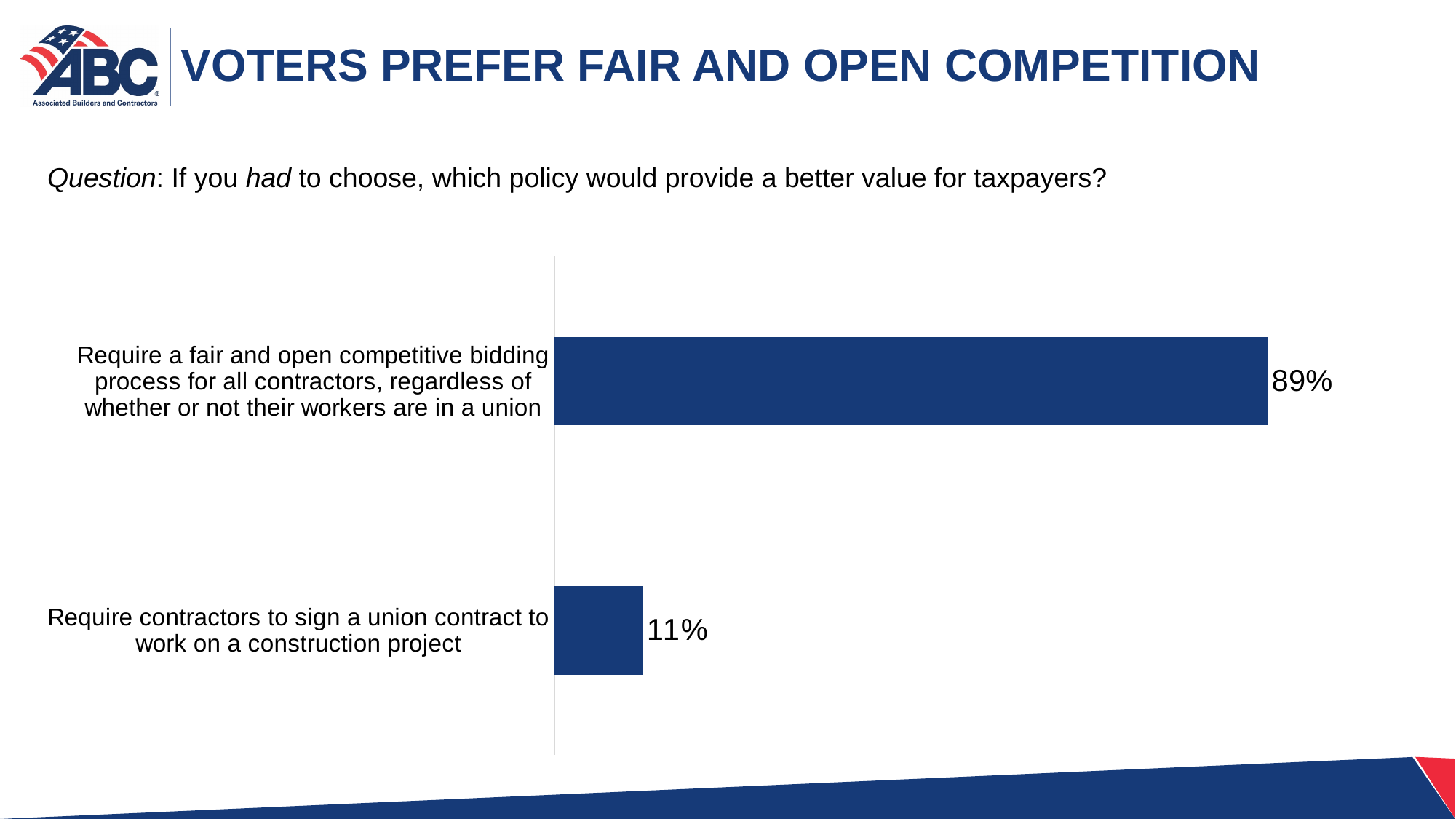
What is the title of the slide containing the chart? VOTERS PREFER FAIR AND OPEN COMPETITION How many policy options are shown in the chart? 2 Which policy option received the highest share of voters? Require a fair and open competitive bidding process for all contractors, regardless of whether or not their workers are in a union Which policy option received the lowest share of voters? Require contractors to sign a union contract to work on a construction project Which option has the larger value: fair and open competitive bidding or requiring a union contract? Require a fair and open competitive bidding process for all contractors, regardless of whether or not their workers are in a union What colour are the bars in the chart? Dark blue What is the difference in percentage points between the fair and open competitive bidding option and the union contract option? 78 What percentage of voters chose requiring contractors to sign a union contract to work on a construction project? 11% What is the total of the two percentages shown in the chart? 100% What kind of chart is shown on the slide? Bar chart What percentage of voters chose requiring a fair and open competitive bidding process for all contractors? 89%